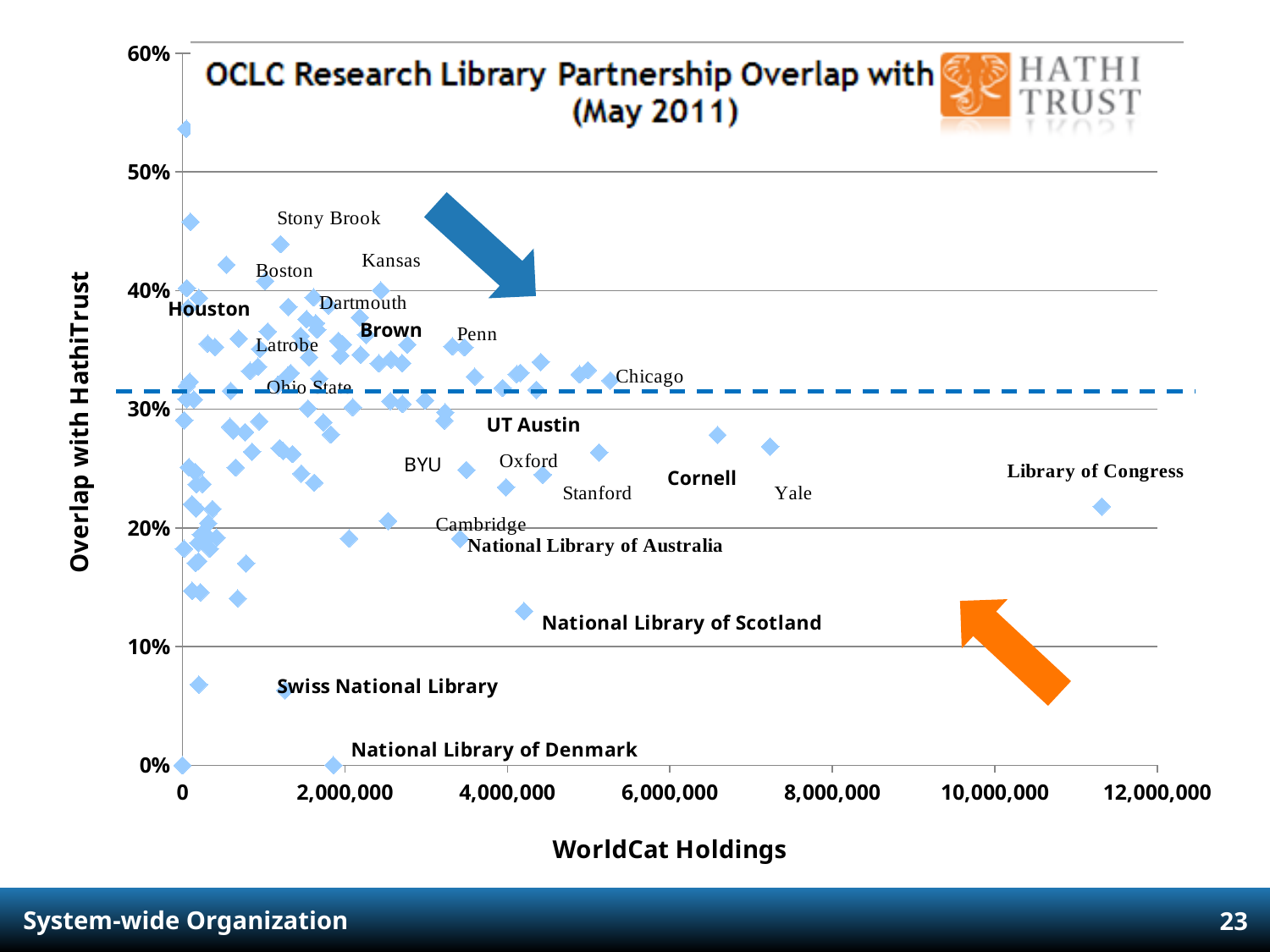
What is the title of the chart? OCLC Research Library Partnership Overlap with HathiTrust (May 2011) Is the WorldCat Holdings value for Library of Congress greater or less than 10,000,000? greater Which labeled library has the largest WorldCat Holdings? Library of Congress Which has the larger WorldCat Holdings, Yale or Cornell? Yale Is the overlap with HathiTrust for National Library of Scotland greater or less than 20%? less Which labeled library has the lowest overlap with HathiTrust? National Library of Denmark Is the overlap with HathiTrust for Swiss National Library greater or less than 10%? less Which has the higher overlap with HathiTrust, Library of Congress or National Library of Scotland? Library of Congress What is the label of the x axis? WorldCat Holdings What kind of chart is shown on the slide? scatter chart